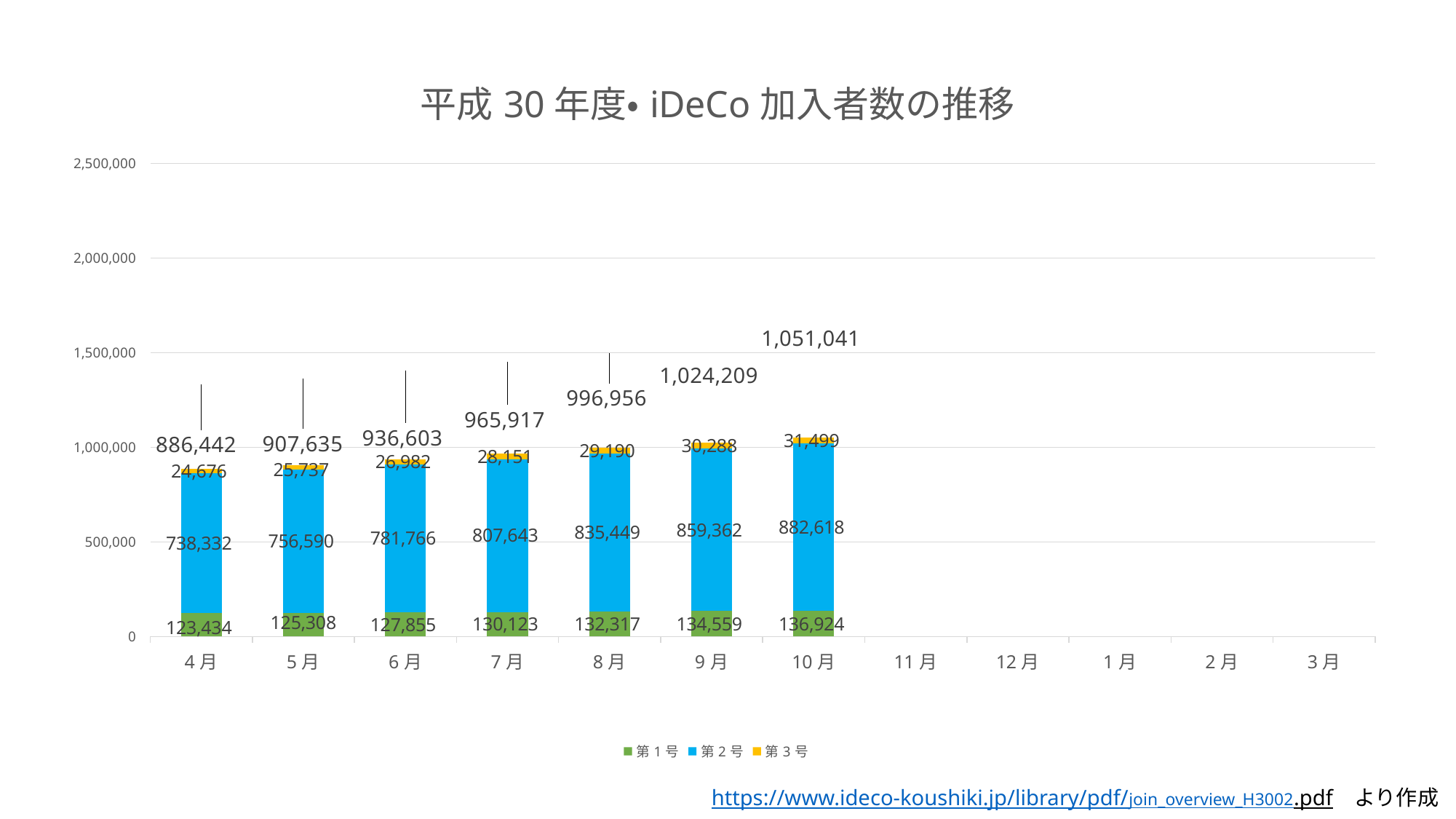
How many series does the legend list? 3 What is the value of 第2号 for 7月? 807,643 Which is larger, the 第3号 value for 8月 or the 第3号 value for 9月? 9月 Which month has the highest total number of participants among the months with data? 10月 What is the total of the stacked bar for 10月? 1,051,041 What is the difference between the 第2号 values for 10月 and 4月? 144,286 Do the total values rise or fall from 4月 to 10月? rise How many month categories are shown on the x axis? 12 What is the value of 第3号 for 10月? 31,499 What type of chart is shown on the slide? stacked bar chart What is the title of the chart? 平成 30 年度• iDeCo 加入者数の推移 What is the value of 第1号 for 4月? 123,434